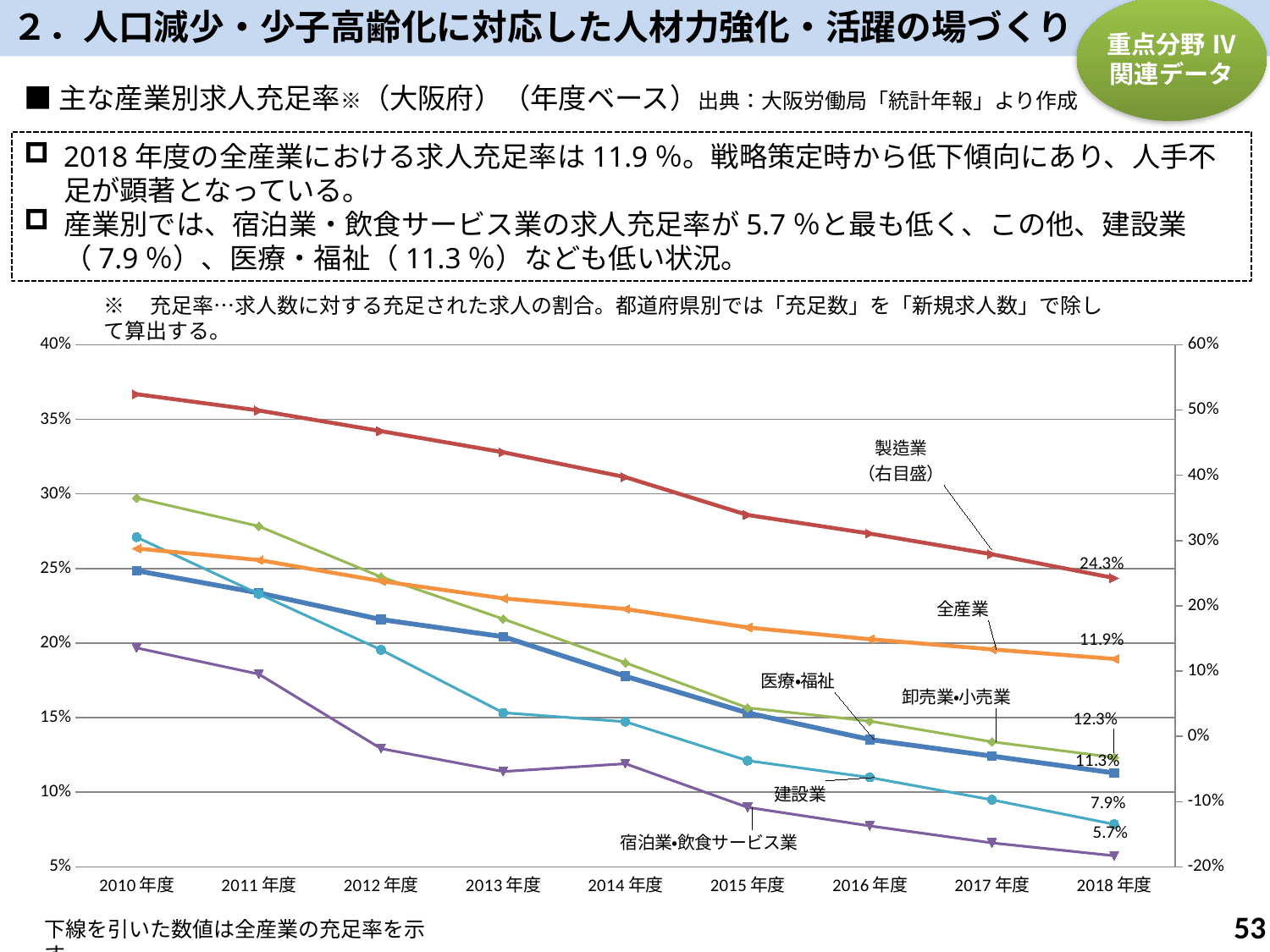
What is the value for 建設業 in 2018年度? 7.9% What is the value for 卸売業・小売業 in 2018年度? 12.3% What is the value for 製造業 in 2018年度? 24.3% What is the difference between 卸売業・小売業 and 医療・福祉 in 2018年度? 1.0% Which is larger in 2018年度, 建設業 or 宿泊業・飲食サービス業? 建設業 What is the value for 宿泊業・飲食サービス業 in 2018年度? 5.7% What is the difference between 全産業 and 宿泊業・飲食サービス業 in 2018年度? 6.2% What is the value for 全産業 in 2018年度? 11.9% How many fiscal years are plotted on the x axis? 9 Is the value for 全産業 in 2010年度 greater or less than 20%? greater Which industry has the lowest value in 2018年度? 宿泊業・飲食サービス業 What kind of chart is shown on the slide? line chart